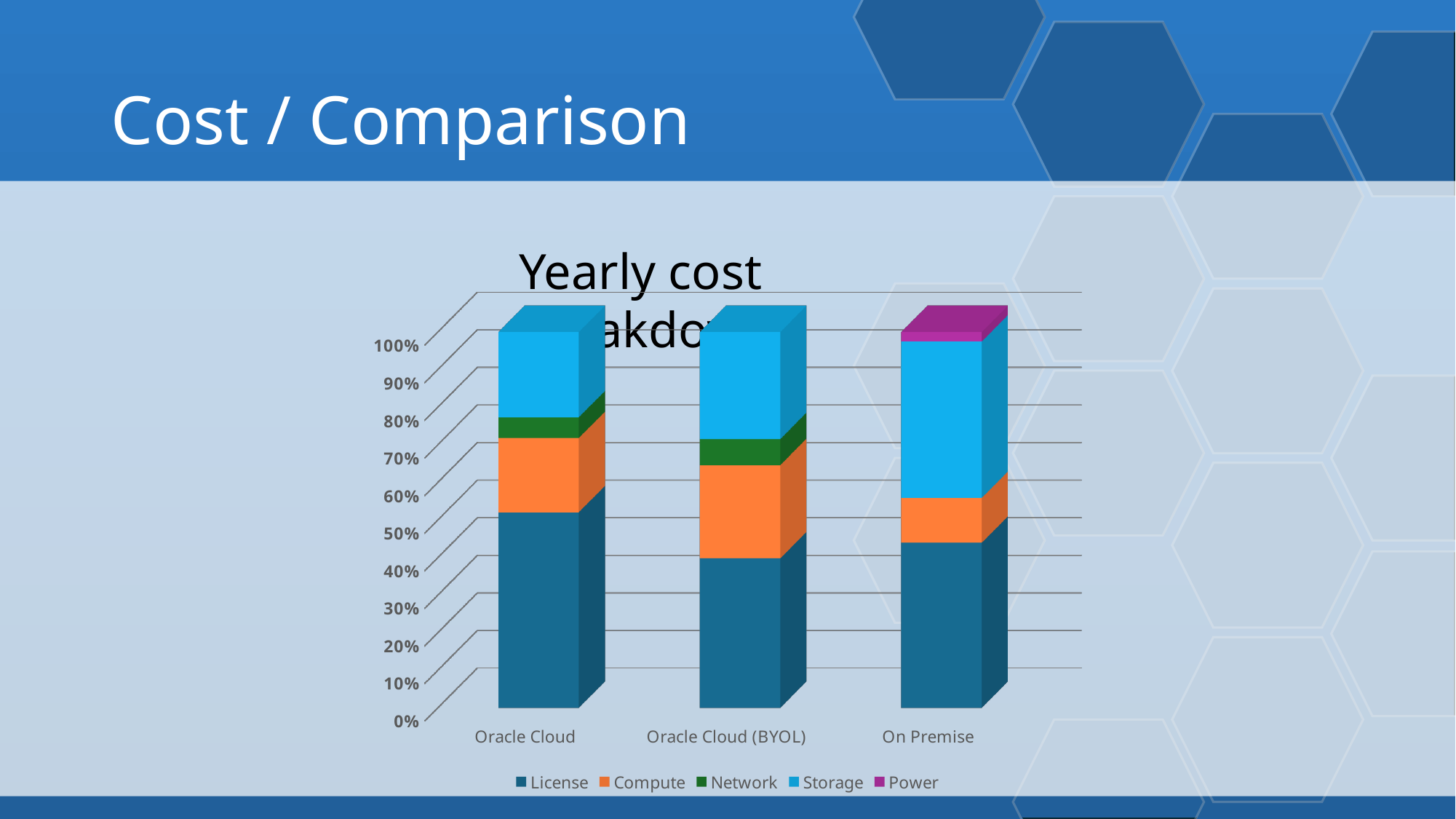
Which category has the largest Storage share of its bar? On Premise Is the License share for Oracle Cloud greater or less than 40%? greater Is the Storage share for On Premise greater or less than 30%? greater How many categories are shown on the x axis of the chart? 3 Is the Compute share larger for Oracle Cloud (BYOL) or for On Premise? Oracle Cloud (BYOL) What kind of chart is shown on the slide? Stacked bar chart Which category has the smallest License share of its bar? Oracle Cloud (BYOL) How many series does the chart's legend list? 5 Is the License share larger for Oracle Cloud or for Oracle Cloud (BYOL)? Oracle Cloud Is the License share for Oracle Cloud (BYOL) greater or less than 50%? less Which category is the only one with a Power segment in its bar? On Premise What are the series names listed in the chart's legend? License, Compute, Network, Storage, Power